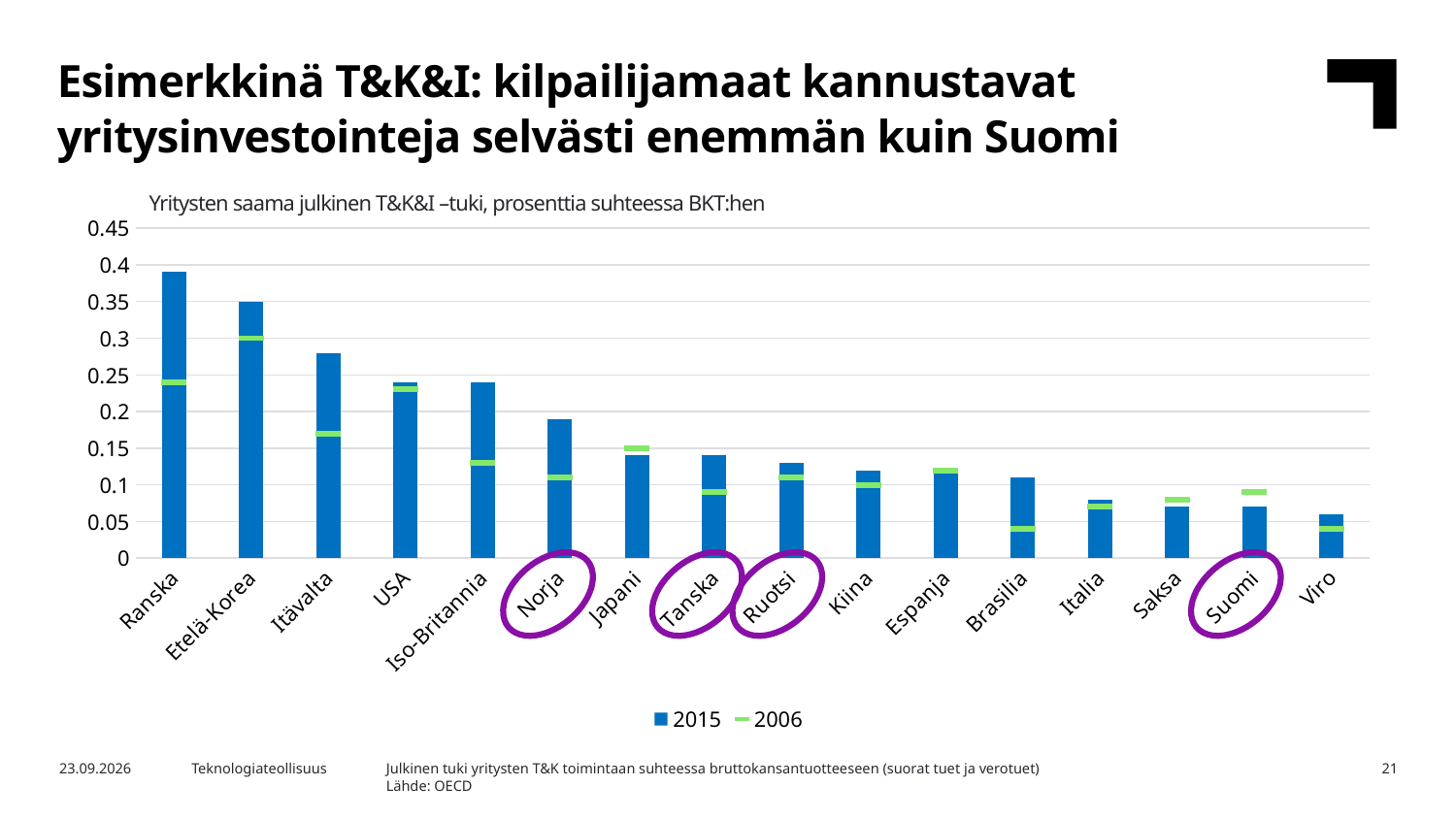
Which two years are listed in the chart legend? 2015 and 2006 How many series does the chart legend list? 2 Which country has the highest 2015 value in the chart? Ranska How many countries are shown on the x axis of the chart? 16 What kind of chart is shown on the slide? bar chart Is the 2015 value for Ranska greater or less than 0.35? greater Is the 2015 value for Itävalta greater or less than 0.25? greater Which has the larger 2015 value, Ranska or Suomi? Ranska Which country has the lowest 2015 value in the chart? Viro Is the 2015 value for Norja greater or less than 0.15? greater Do the 2015 values generally rise or fall from left to right along the x axis? fall